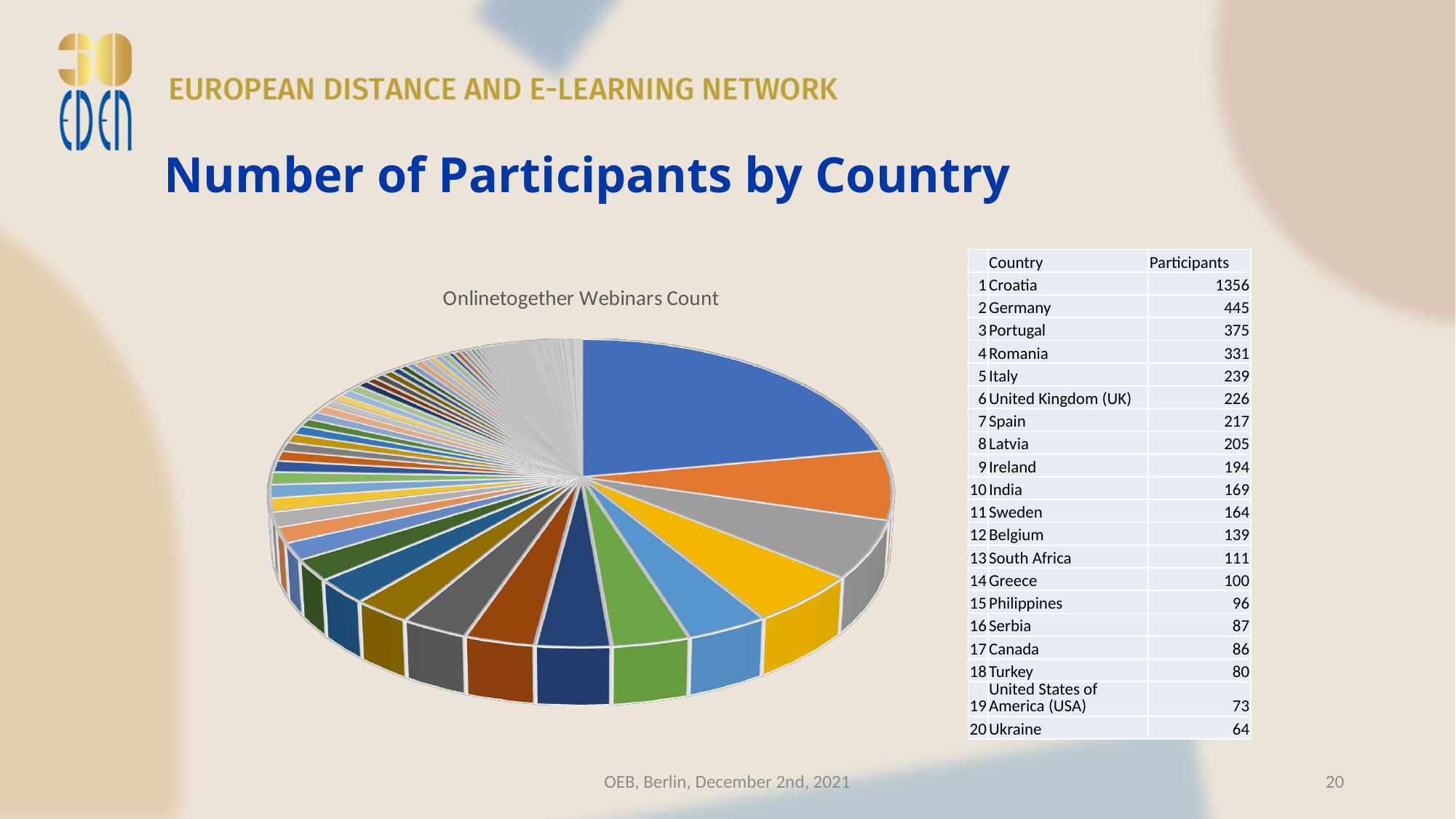
Of the 20 countries listed in the table, which has the fewest participants? Ukraine What is the difference in participants between Croatia and Germany? 911 What is the title printed above the pie chart? Onlinetogether Webinars Count Which has more participants, Italy or the United Kingdom (UK)? Italy How many participants does the slide list for Portugal? 375 What is the difference in participants between Germany and Portugal? 70 What colour is the largest slice of the pie chart? Blue How many participants does the slide list for Croatia? 1356 How many participants does the slide list for Ukraine? 64 How many participants does the slide list for Germany? 445 Which country accounts for the largest slice of the pie chart? Croatia What kind of chart is shown on the slide? Pie chart